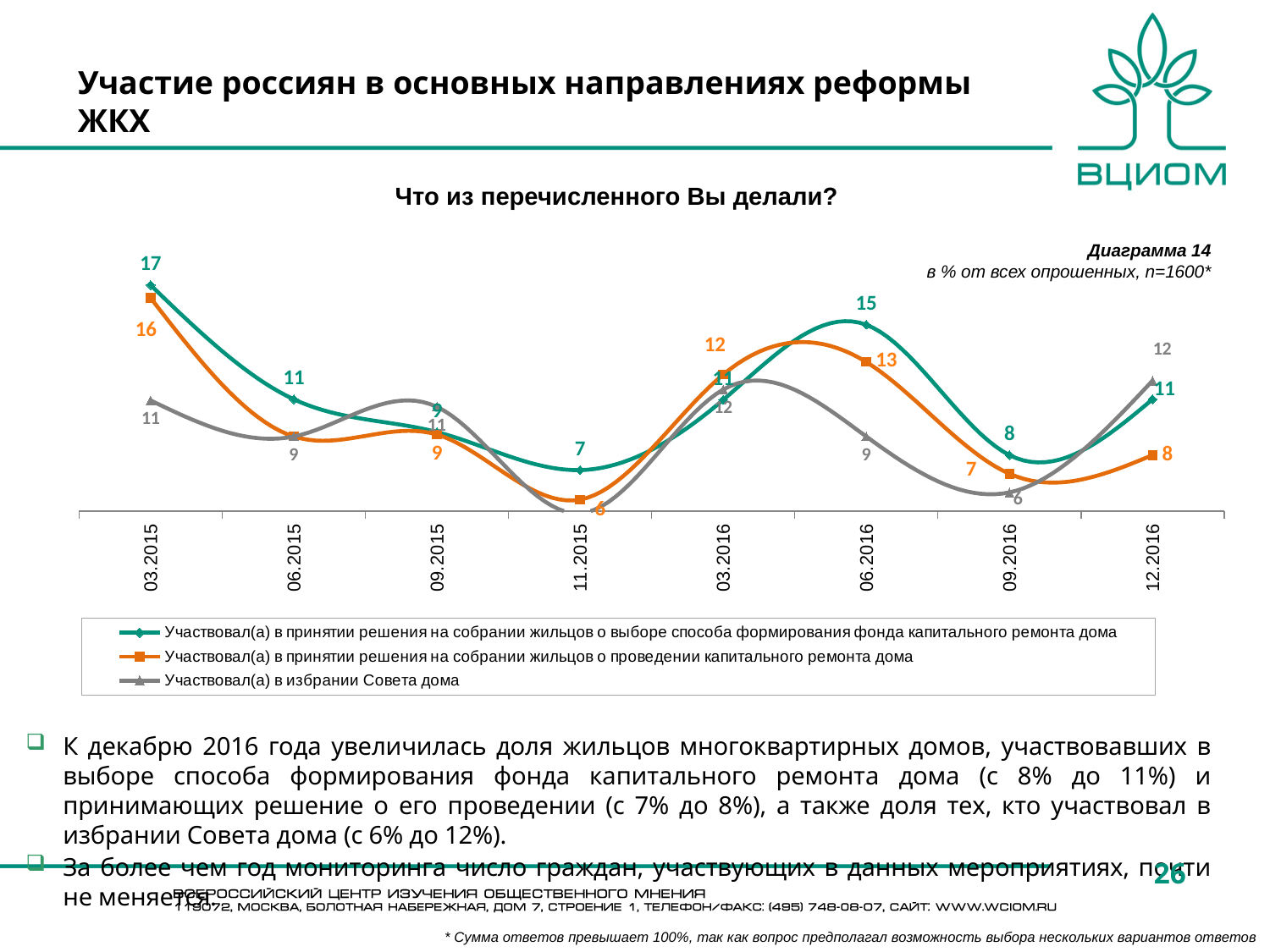
What is the value for the series 'Участвовал(а) в принятии решения на собрании жильцов о проведении капитального ремонта дома' at 06.2016? 13 By how much did the value for 'Участвовал(а) в принятии решения на собрании жильцов о выборе способа формирования фонда капитального ремонта дома' change between 03.2015 and 12.2016? 6 What is the title of the chart? Что из перечисленного Вы делали? What kind of chart is shown on the slide? line chart At which date does the series 'Участвовал(а) в принятии решения на собрании жильцов о проведении капитального ремонта дома' reach its lowest value? 11.2015 At which date does the series 'Участвовал(а) в принятии решения на собрании жильцов о выборе способа формирования фонда капитального ремонта дома' reach its highest value? 03.2015 What is the value for the series 'Участвовал(а) в принятии решения на собрании жильцов о выборе способа формирования фонда капитального ремонта дома' at 03.2015? 17 How many series does the legend list? 3 At 06.2016, which series has the larger value: 'Участвовал(а) в принятии решения на собрании жильцов о выборе способа формирования фонда капитального ремонта дома' or 'Участвовал(а) в принятии решения на собрании жильцов о проведении капитального ремонта дома'? Участвовал(а) в принятии решения на собрании жильцов о выборе способа формирования фонда капитального ремонта дома What is the value for the series 'Участвовал(а) в избрании Совета дома' at 12.2016? 12 Does the series 'Участвовал(а) в принятии решения на собрании жильцов о выборе способа формирования фонда капитального ремонта дома' rise or fall from 03.2015 to 11.2015? fall How many time points are shown on the x axis? 8